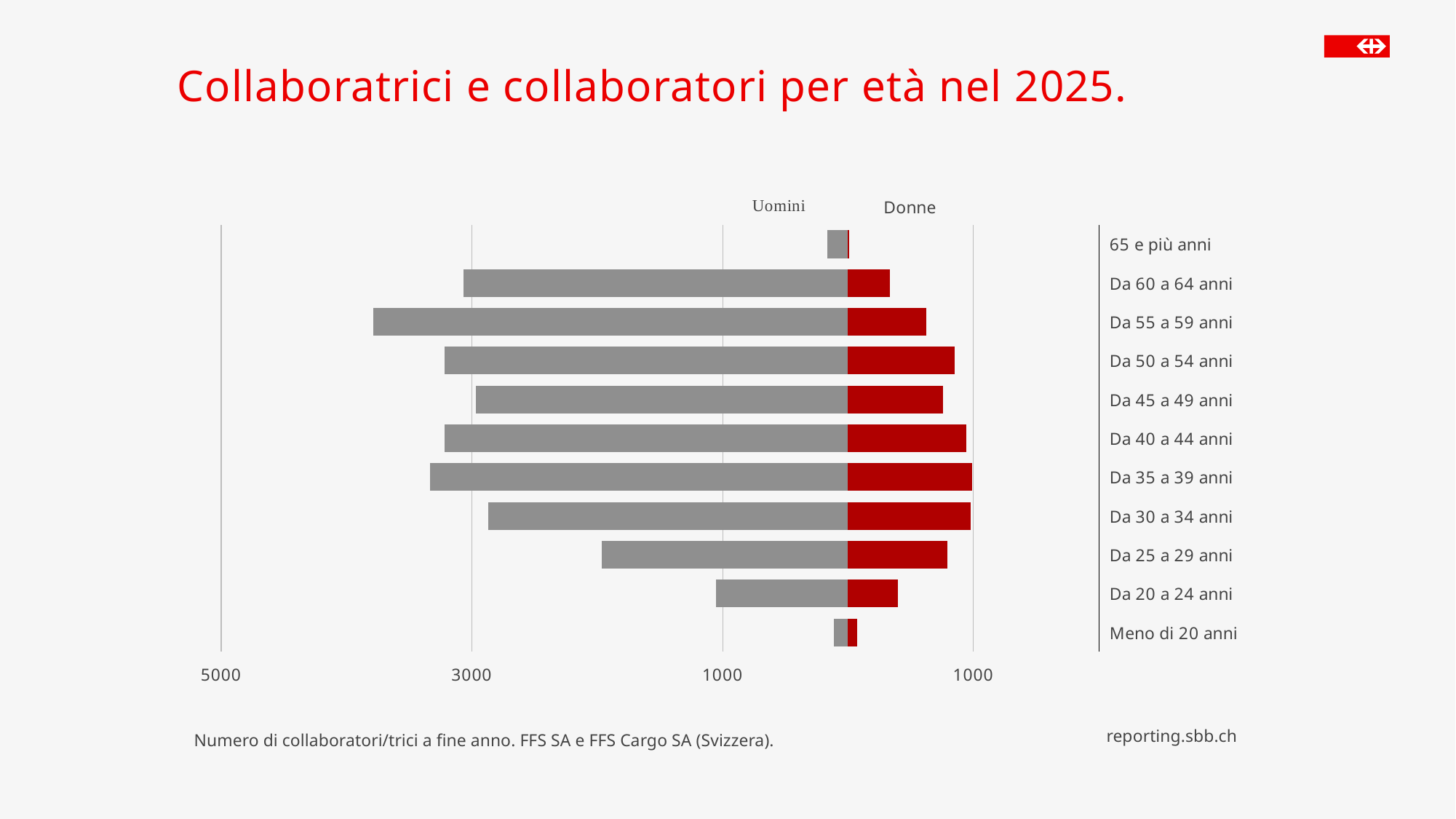
Which is larger for Donne: Da 20 a 24 anni or Da 55 a 59 anni? Da 55 a 59 anni How many series does the chart show? 2 Which age group has the highest value for Uomini? Da 55 a 59 anni Which is larger for Uomini: Da 25 a 29 anni or Da 30 a 34 anni? Da 30 a 34 anni What kind of chart is shown on the slide? bar chart Is the Donne value for Da 60 a 64 anni greater or less than 1000? less Is the Uomini value for Da 55 a 59 anni greater or less than 3000? greater Which is larger for Uomini: Da 55 a 59 anni or Da 60 a 64 anni? Da 55 a 59 anni Which age group has the lowest value for Donne? 65 e più anni How many age groups are shown in the chart? 11 What colour are the Donne bars in the chart? red Is the Uomini value for Da 25 a 29 anni greater or less than 3000? less